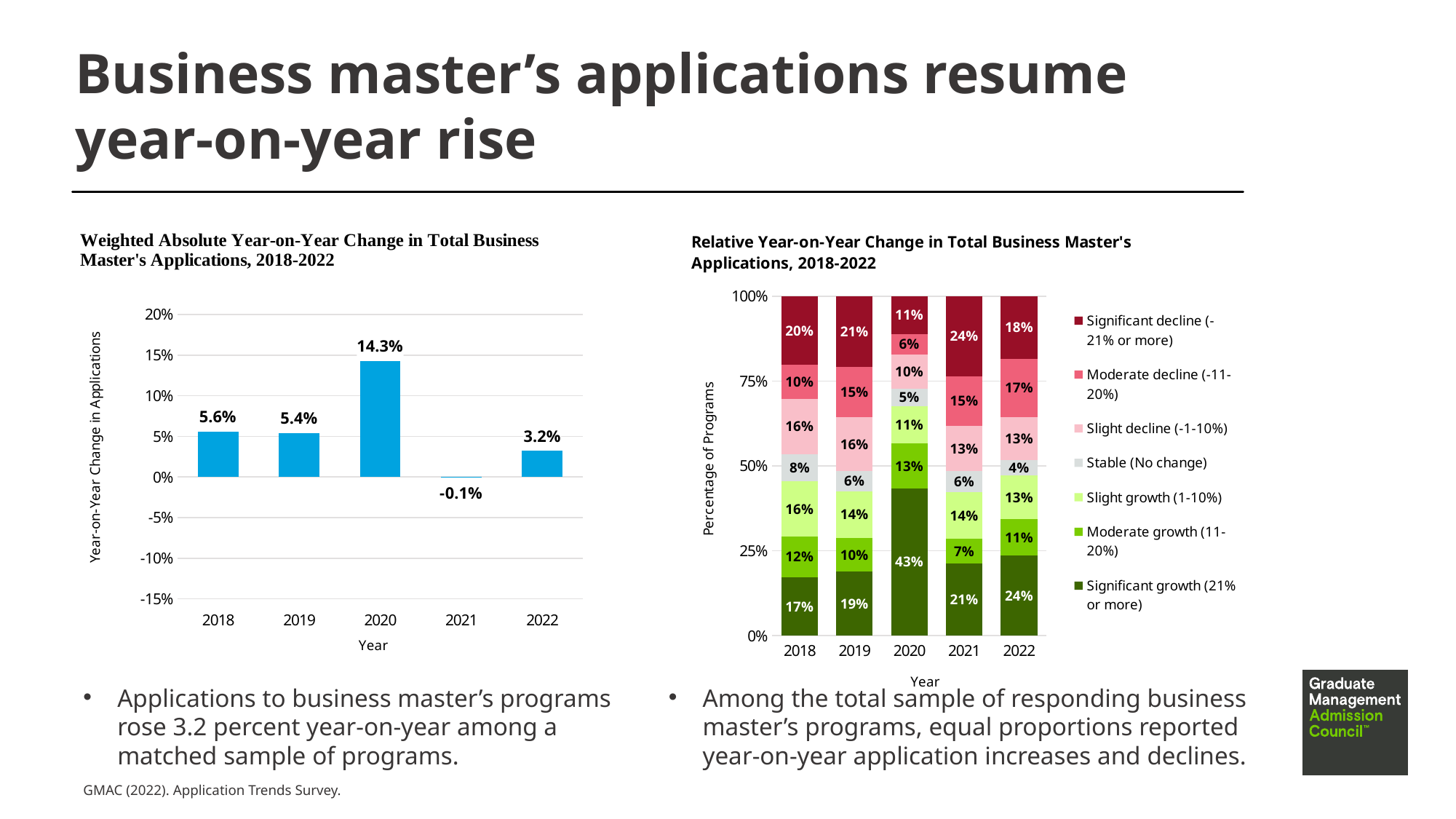
In the left chart (Weighted Absolute Year-on-Year Change), which year has the highest value? 2020 In the left chart (Weighted Absolute Year-on-Year Change), what is the difference between the 2020 value and the 2022 value? 11.1 percentage points In the right chart (Relative Year-on-Year Change), what percentage of programs reported significant growth in 2020? 43% In the left chart (Weighted Absolute Year-on-Year Change), what is the value for 2020? 14.3% In the left chart (Weighted Absolute Year-on-Year Change), how many years are plotted? 5 In the left chart (Weighted Absolute Year-on-Year Change), what is the value for 2021? -0.1% What kind of chart is the left chart (Weighted Absolute Year-on-Year Change)? Bar chart In the right chart (Relative Year-on-Year Change), what percentage of programs reported significant decline in 2021? 24% In the left chart (Weighted Absolute Year-on-Year Change), which year has the lowest value? 2021 In the right chart (Relative Year-on-Year Change), which is larger: the moderate decline share in 2019 or in 2022? 2022 In the right chart (Relative Year-on-Year Change), how many series does the legend list? 7 In the right chart (Relative Year-on-Year Change), what is the difference between the significant growth share in 2022 and in 2018? 7 percentage points